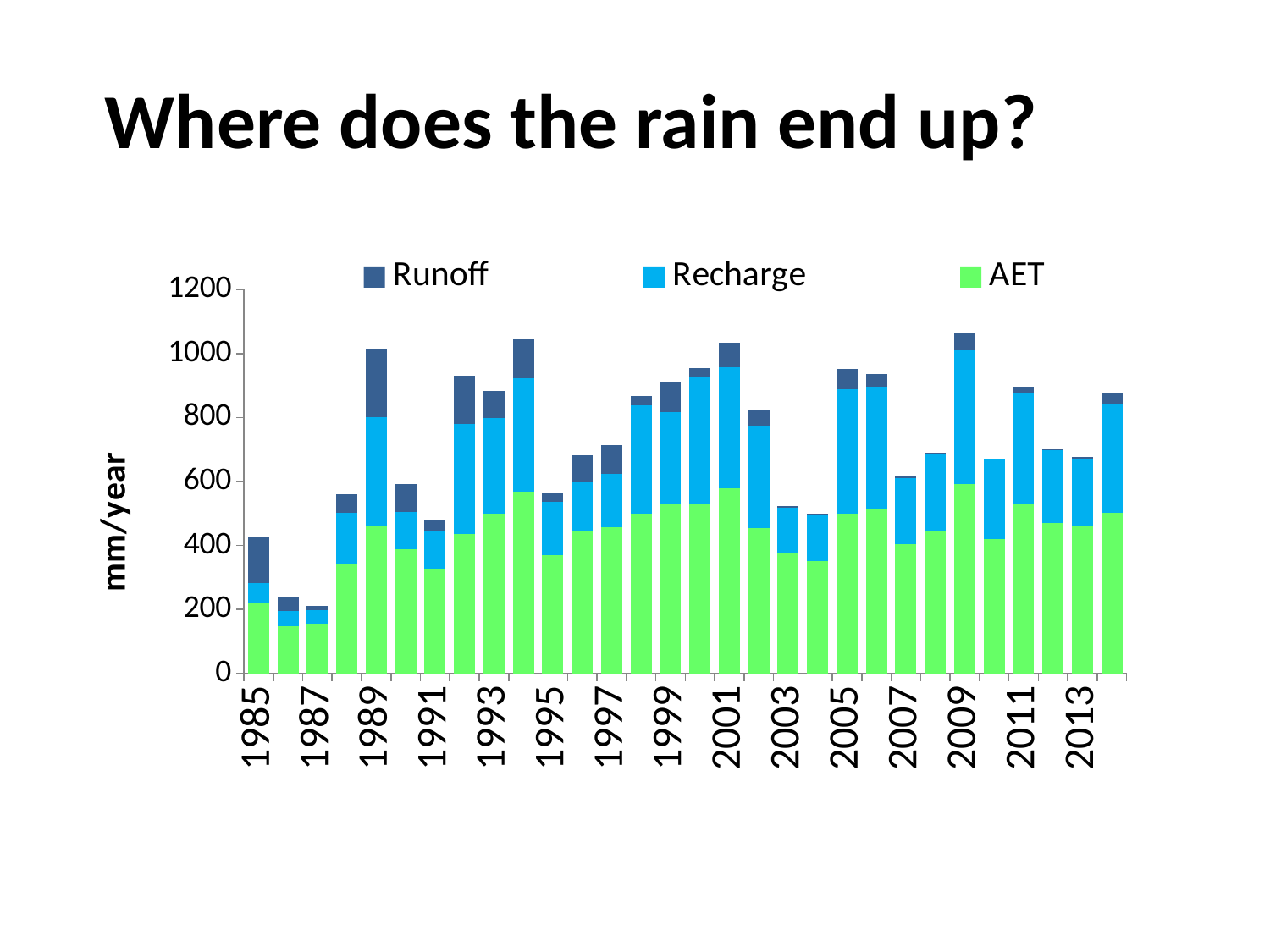
What is the label on the vertical axis? mm/year How many years (bars) are plotted in the chart? 30 Which year has the taller total bar, 1989 or 1990? 1989 What kind of chart is shown on the slide? stacked bar chart Which year has the taller total bar, 2005 or 2007? 2005 Is the total bar height for 2005 greater or less than 800? greater How many series does the legend list? 3 Is the total bar height for 1986 greater or less than 400? less Which year has the taller total bar, 1985 or 1988? 1988 Is the total bar height for 2012 greater or less than 800? less Which series is shown in green? AET